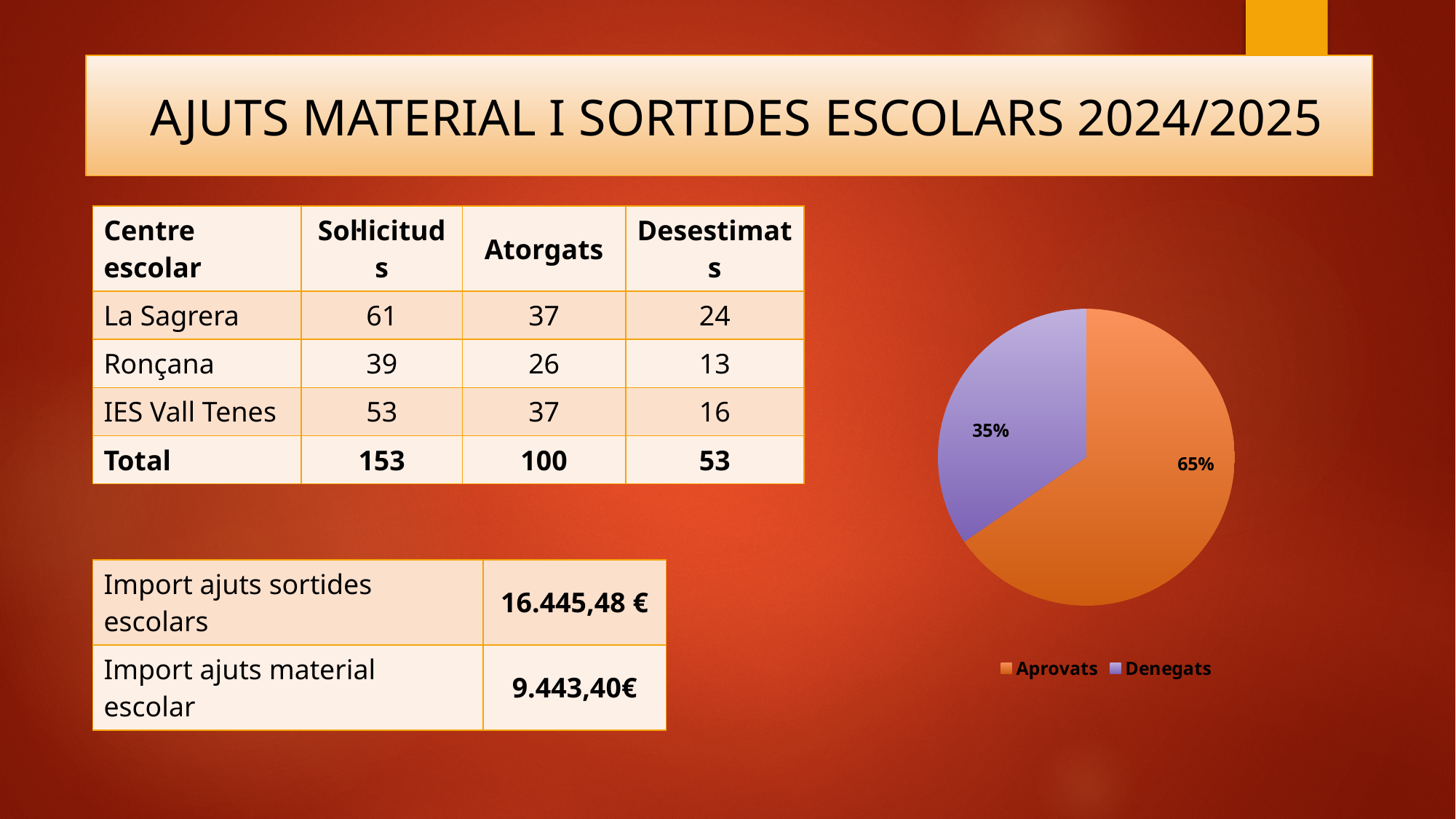
What percentage of the pie chart is Denegats? 35% Which slice of the pie chart is the largest? Aprovats How many slices does the pie chart have? 2 What is the difference in percentage points between the Aprovats and Denegats slices of the pie chart? 30 What kind of chart is shown on the slide? pie chart What are the two legend entries of the pie chart? Aprovats and Denegats What percentage of the pie chart is Aprovats? 65% In the pie chart, which is larger, Aprovats or Denegats? Aprovats Which slice of the pie chart is the smallest? Denegats How many entries does the pie chart legend list? 2 What colour is the Aprovats slice in the pie chart? orange What share of the pie does the Denegats slice represent? 35%